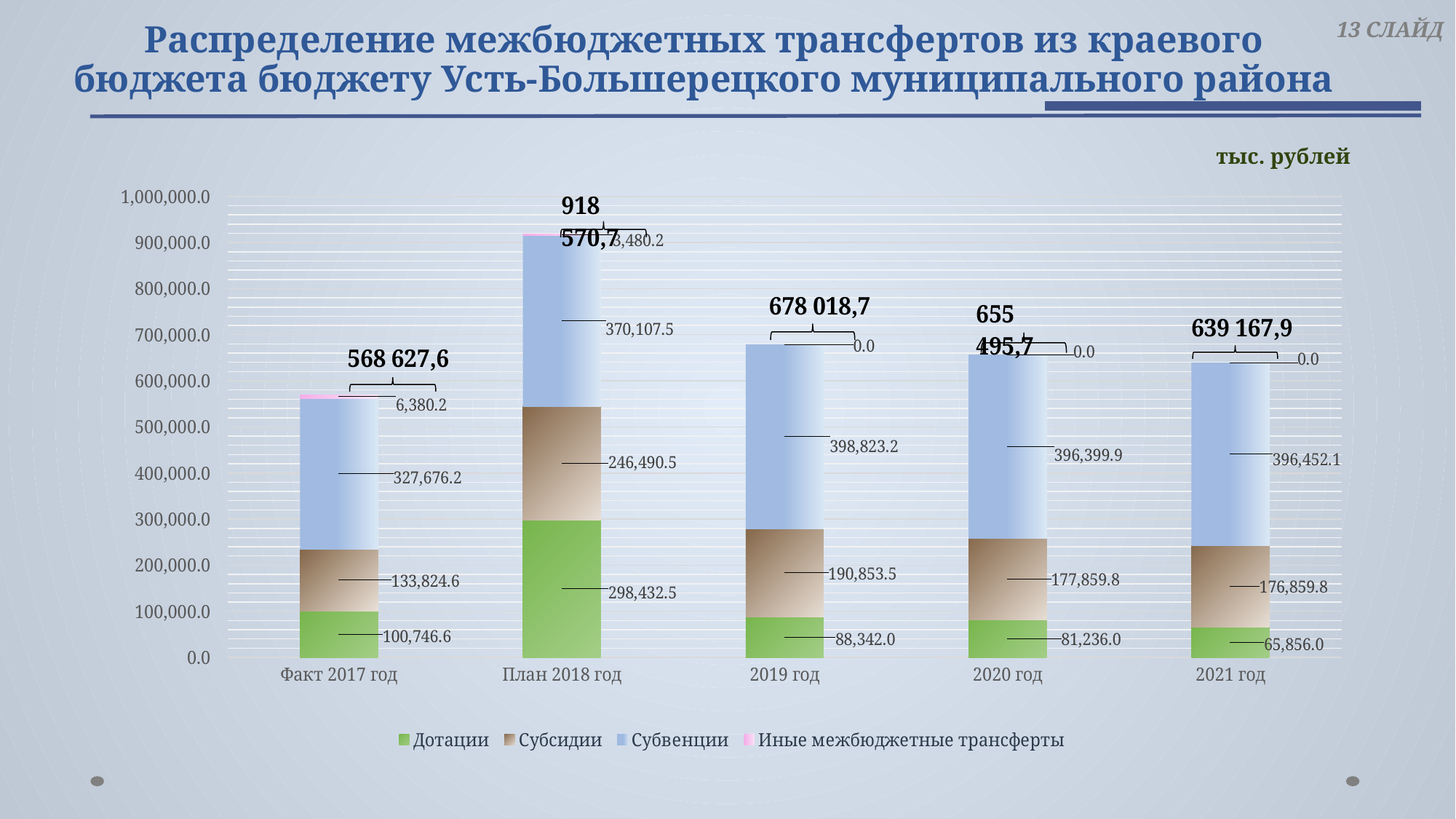
How many series does the legend list? 4 What is the value of Дотации for Факт 2017 год? 100,746.6 Which category has the highest value for Дотации? План 2018 год What is the value of Субсидии for План 2018 год? 246,490.5 What is the difference between the Субсидии values for 2020 год and 2021 год? 1,000.0 What type of chart is shown on the slide? stacked bar chart Which category has the lowest value for Дотации? 2021 год What is the value of Иные межбюджетные трансферты for Факт 2017 год? 6,380.2 How many categories are shown on the x axis? 5 What is the value of Субвенции for 2019 год? 398,823.2 What is the total shown above the bar for 2021 год? 639 167,9 Which is larger: Субвенции for 2020 год or Субвенции for 2021 год? 2021 год